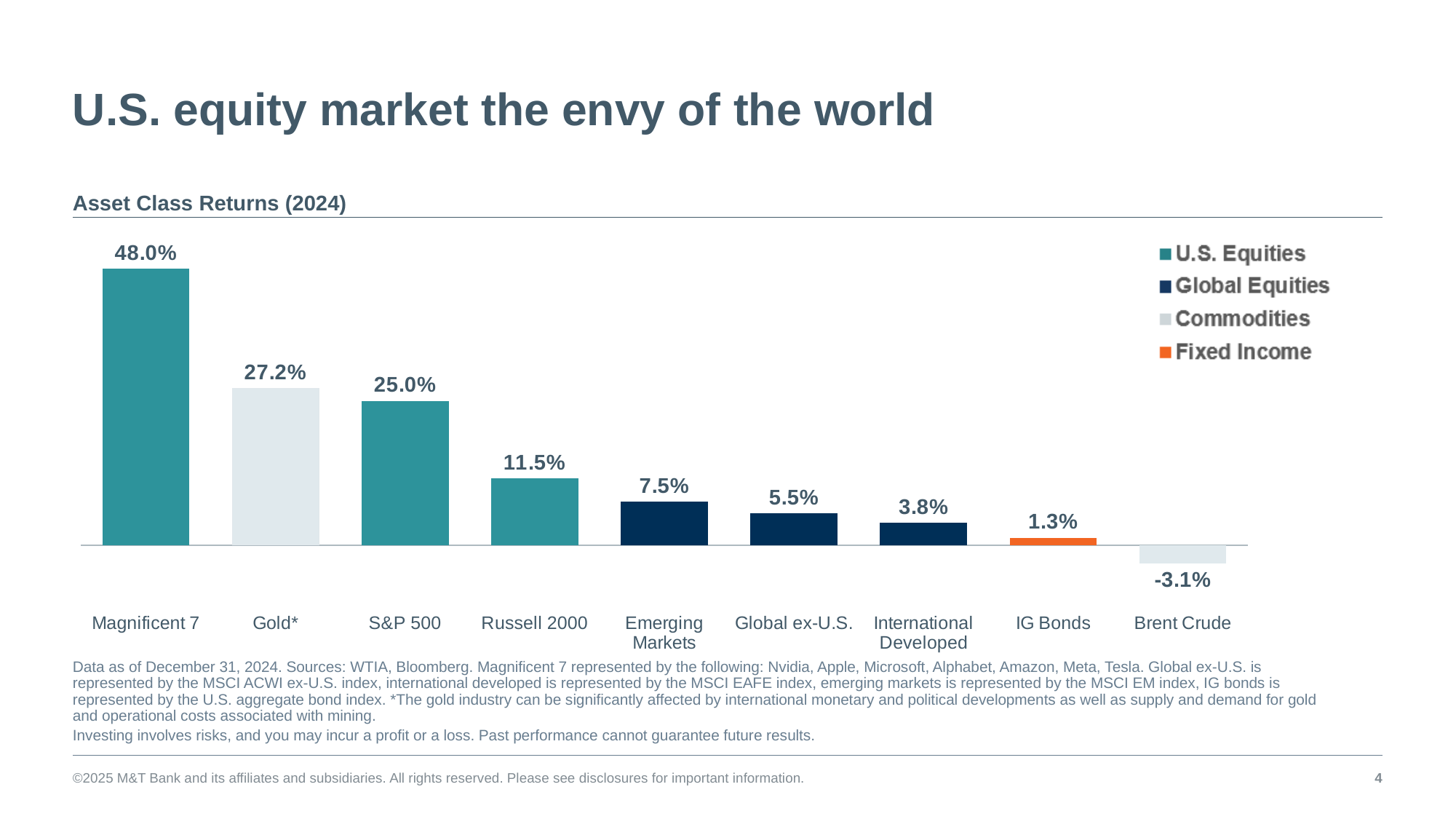
What is the difference between the S&P 500 return and the Russell 2000 return? 13.5% What is the 2024 return shown for the Magnificent 7? 48.0% How many categories are shown on the chart? 9 What is the title of the chart? Asset Class Returns (2024) How many series does the legend list? 4 What is the return shown for Brent Crude? -3.1% What kind of chart is shown on the slide? Bar chart Which has the larger return, Emerging Markets or Global ex-U.S.? Emerging Markets What is the return shown for International Developed? 3.8% Which category has the highest return on the chart? Magnificent 7 Which category has the lowest return on the chart? Brent Crude What is the return shown for Gold*? 27.2%